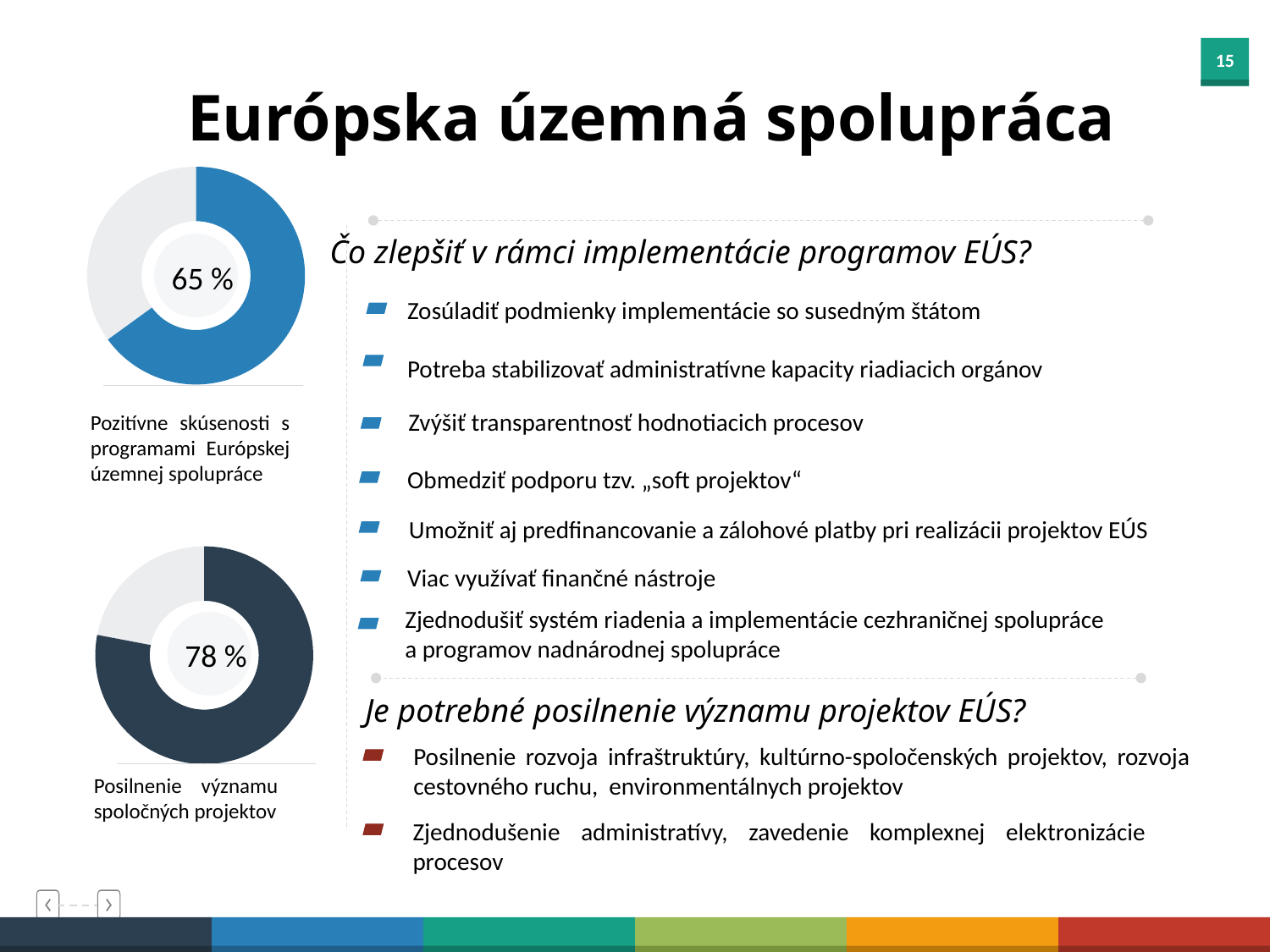
How many donut charts are shown on the slide? 2 What value is shown in the centre of the top donut chart (Pozitívne skúsenosti s programami Európskej územnej spolupráce)? 65 % What kind of chart is used for the top chart on the left of the slide? Donut (pie) chart What value is shown in the centre of the bottom donut chart (Posilnenie významu spoločných projektov)? 78 % What is the caption under the bottom donut chart showing 78 %? Posilnenie významu spoločných projektov Which of the two donut charts shows the larger value, the top one (Pozitívne skúsenosti) or the bottom one (Posilnenie významu spoločných projektov)? The bottom one (78 %) What is the difference in percentage points between the bottom donut chart value (78 %) and the top donut chart value (65 %)? 13 percentage points Is the value shown in the bottom donut chart (Posilnenie významu spoločných projektov) greater or less than 80 %? less What colour is the filled portion of the top donut chart? Blue What share of the top donut chart is left unfilled (grey) if the filled portion is 65 %? 35 % Is the value shown in the top donut chart (Pozitívne skúsenosti) greater or less than 50 %? greater